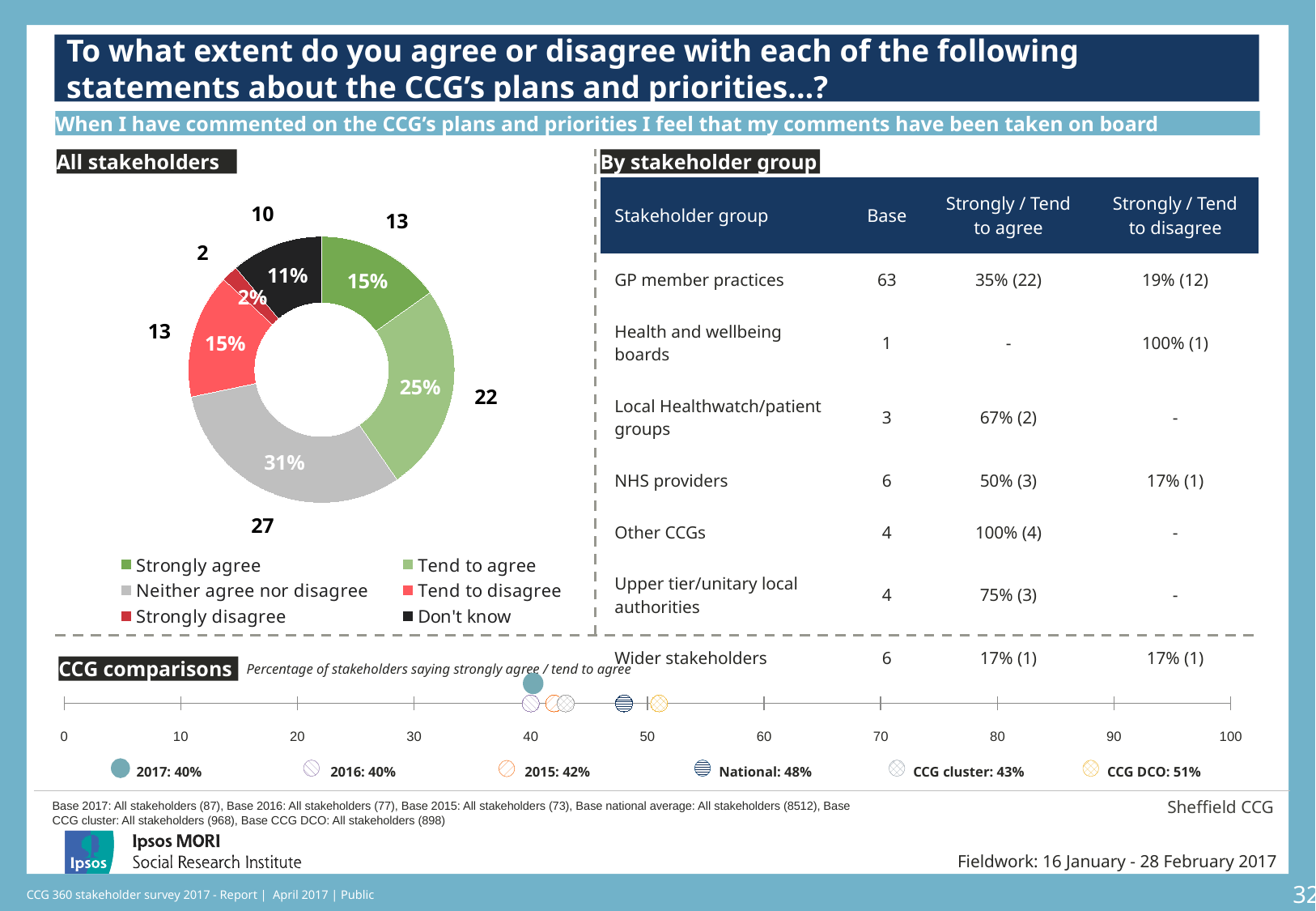
In the 'All stakeholders' donut chart, how many respondents are shown next to the 'Neither agree nor disagree' segment? 27 In the 'All stakeholders' donut chart, what percentage of stakeholders said 'Tend to agree'? 25% In the 'All stakeholders' donut chart, which is larger: the share for 'Don't know' or the share for 'Strongly disagree'? Don't know In the 'All stakeholders' donut chart, what percentage of stakeholders said 'Don't know'? 11% What type of chart is used for the 'All stakeholders' section? Donut chart In the 'All stakeholders' donut chart, which response category has the largest share? Neither agree nor disagree How many response categories does the legend of the 'All stakeholders' donut chart list? 6 In the 'All stakeholders' donut chart, which response category has the smallest share? Strongly disagree In the 'CCG comparisons' chart, what is the percentage for 2017? 40% In the 'All stakeholders' donut chart, what percentage of stakeholders said 'Neither agree nor disagree'? 31% In the 'All stakeholders' donut chart, what is the difference in percentage points between 'Tend to agree' and 'Strongly agree'? 10 In the 'CCG comparisons' chart, which comparator has the highest percentage of stakeholders saying strongly agree / tend to agree? CCG DCO: 51%